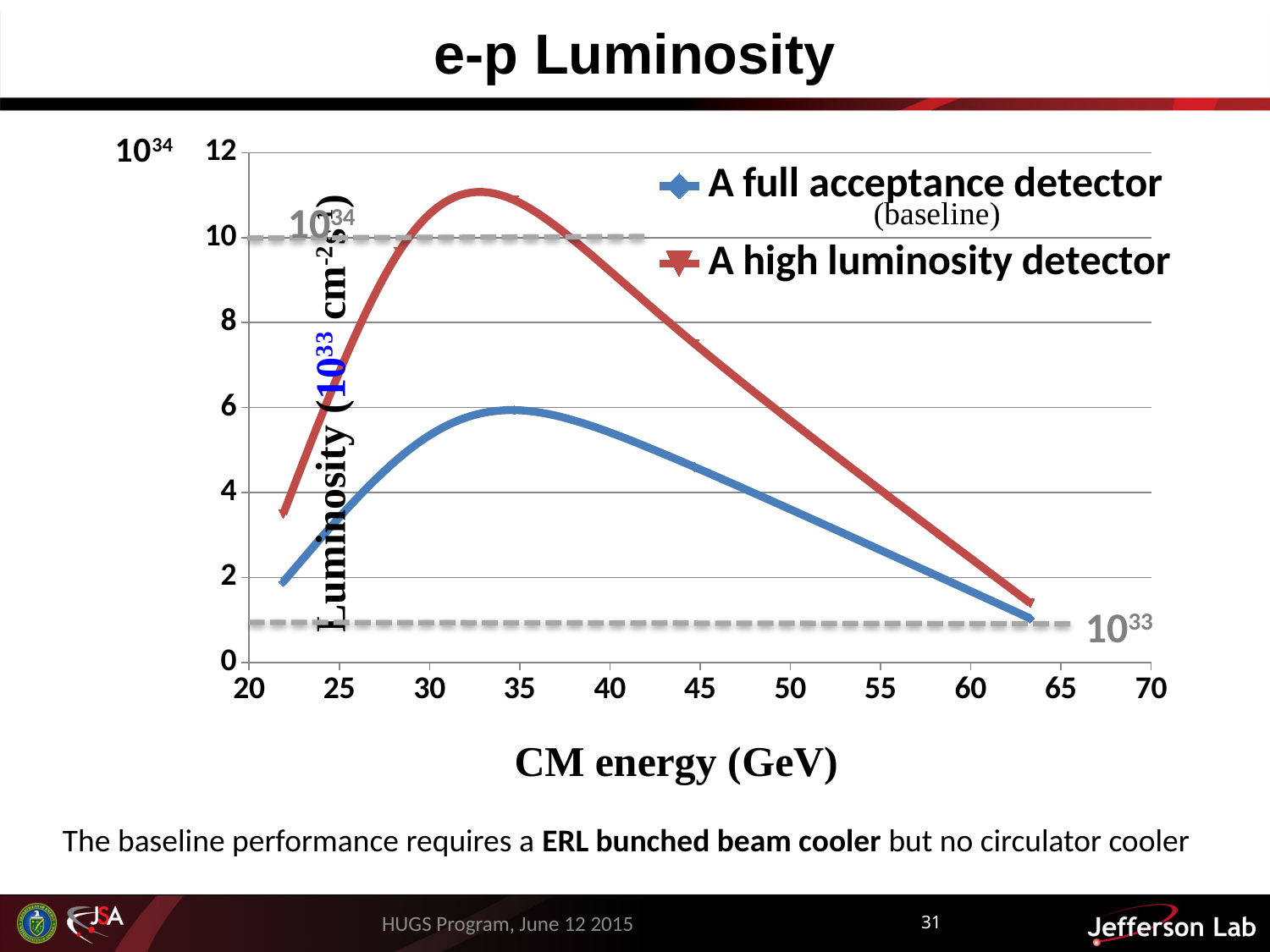
Is the value of the high luminosity detector curve at 25 GeV greater or less than 4? greater What kind of chart is shown on the slide? line chart Which series is drawn in red? A high luminosity detector Between 22 GeV and 33 GeV, does the high luminosity detector curve rise or fall? rise At a CM energy of 45 GeV, which series has the higher luminosity? A high luminosity detector Between 35 GeV and 65 GeV, does the high luminosity detector curve rise or fall? fall Is the value of the full acceptance detector curve at 50 GeV greater or less than 6? less Is the peak value of the high luminosity detector curve greater or less than 10? greater What is the title of the x axis? CM energy (GeV) Which series reaches the higher peak luminosity? A high luminosity detector How many series does the legend list? 2